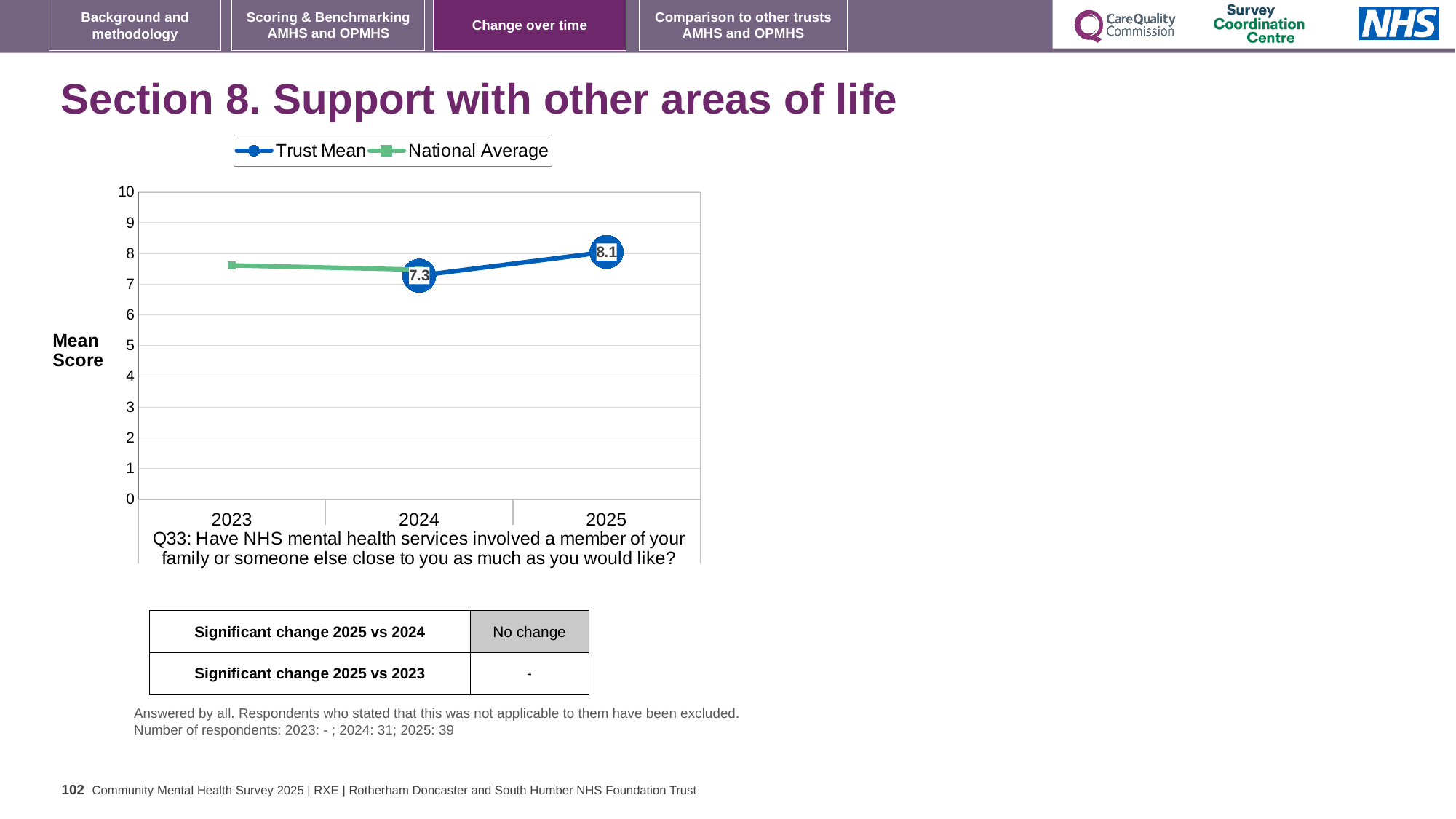
By how much did the Trust Mean score change from 2024 to 2025? 0.8 Does the Trust Mean line rise or fall from 2024 to 2025? rises In which year is the Trust Mean score highest? 2025 Is the National Average value for 2024 greater or less than 8? less Is the National Average value for 2023 greater or less than 7? greater How many series does the legend list? 2 What is the label on the y axis of the chart? Mean Score Which year has the higher Trust Mean score, 2024 or 2025? 2025 What is the Trust Mean score for 2024? 7.3 What kind of chart is shown on the slide? line chart What is the Trust Mean score for 2025? 8.1 How many years are shown on the x axis? 3